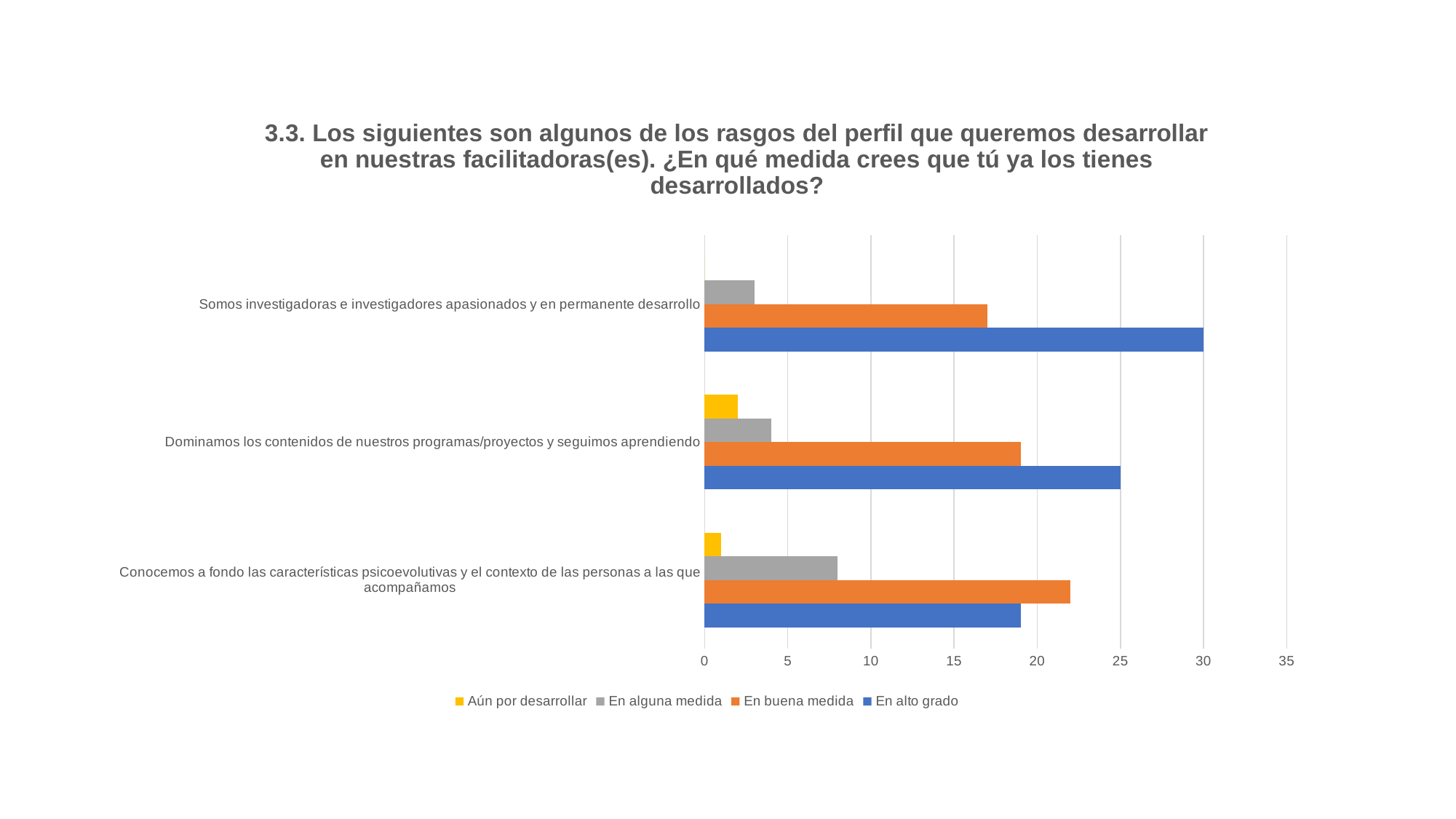
Which category has the lowest 'En alto grado' value? Conocemos a fondo las características psicoevolutivas y el contexto de las personas a las que acompañamos Which category has the highest 'En alto grado' value? Somos investigadoras e investigadores apasionados y en permanente desarrollo How many series does the legend list? 4 What is the value of 'En alto grado' for 'Dominamos los contenidos de nuestros programas/proyectos y seguimos aprendiendo'? 25 For 'Conocemos a fondo las características psicoevolutivas y el contexto de las personas a las que acompañamos', which is larger: 'En buena medida' or 'En alto grado'? En buena medida Is the value of 'En buena medida' for 'Somos investigadoras e investigadores apasionados y en permanente desarrollo' greater or less than 15? greater Is the value of 'En alguna medida' for 'Conocemos a fondo las características psicoevolutivas y el contexto de las personas a las que acompañamos' greater or less than 10? less How many categories are plotted on the chart? 3 What is the value of 'En alto grado' for 'Somos investigadoras e investigadores apasionados y en permanente desarrollo'? 30 Which colour represents the 'Aún por desarrollar' series in the legend? yellow What is the difference between the 'En alto grado' values for 'Somos investigadoras e investigadores apasionados y en permanente desarrollo' and 'Dominamos los contenidos de nuestros programas/proyectos y seguimos aprendiendo'? 5 What kind of chart is shown on the slide? bar chart